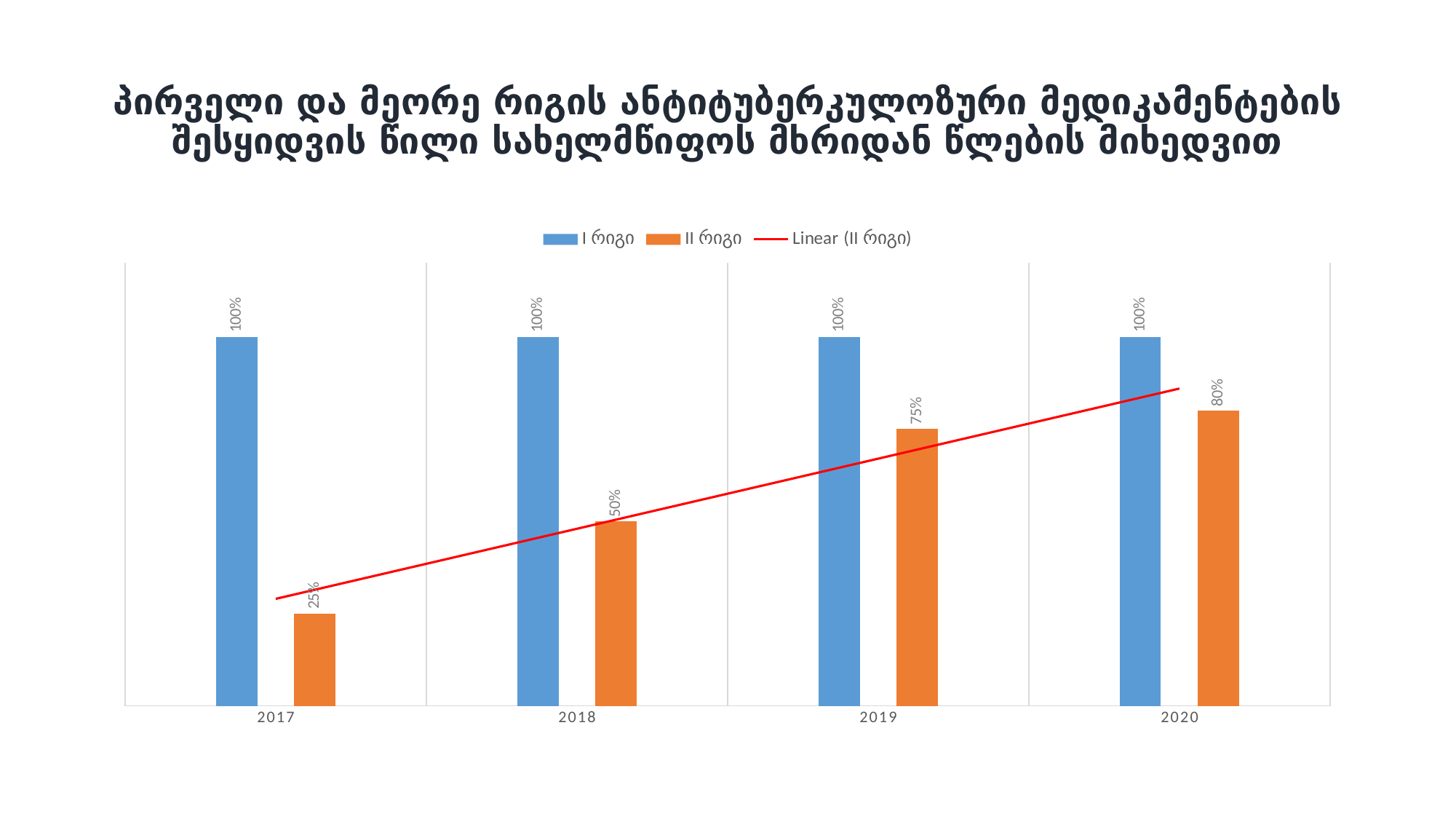
Which is larger in 2019, I რიგი or II რიგი? I რიგი What is the difference between I რიგი and II რიგი in 2018? 50% How many entries does the legend list? 3 What is the value for II რიგი in 2019? 75% What kind of chart is this? Bar chart In which year is the value for II რიგი lowest? 2017 Does the value for II რიგი rise or fall from 2017 to 2020? Rise How many years are shown on the x axis? 4 What is the value for I რიგი in 2020? 100% What is the value for II რიგი in 2020? 80% What is the value for II რიგი in 2017? 25% In which year is the value for II რიგი highest? 2020